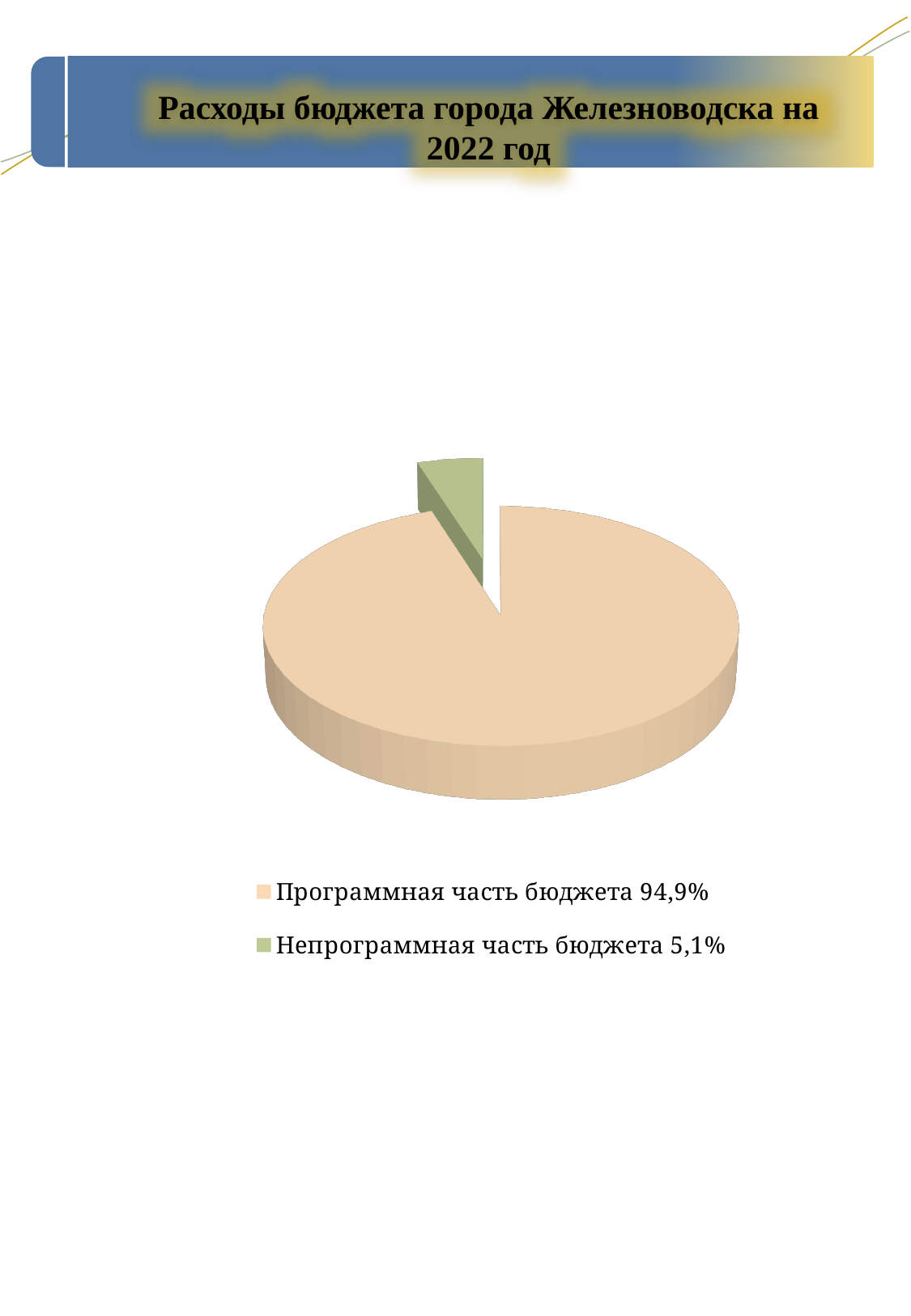
What share of the pie is Непрограммная часть бюджета? 5,1% What colour is the slice for Непрограммная часть бюджета? Green What is the difference in percentage points between Программная часть бюджета and Непрограммная часть бюджета? 89,8 What share of the pie is Программная часть бюджета? 94,9% What is the title of the slide containing the pie chart? Расходы бюджета города Железноводска на 2022 год How many slices does the pie chart have? 2 What kind of chart is shown on the slide? Pie chart How many entries does the legend list? 2 Which slice is the largest in the pie chart? Программная часть бюджета Which is larger: Программная часть бюджета or Непрограммная часть бюджета? Программная часть бюджета Which slice is the smallest in the pie chart? Непрограммная часть бюджета